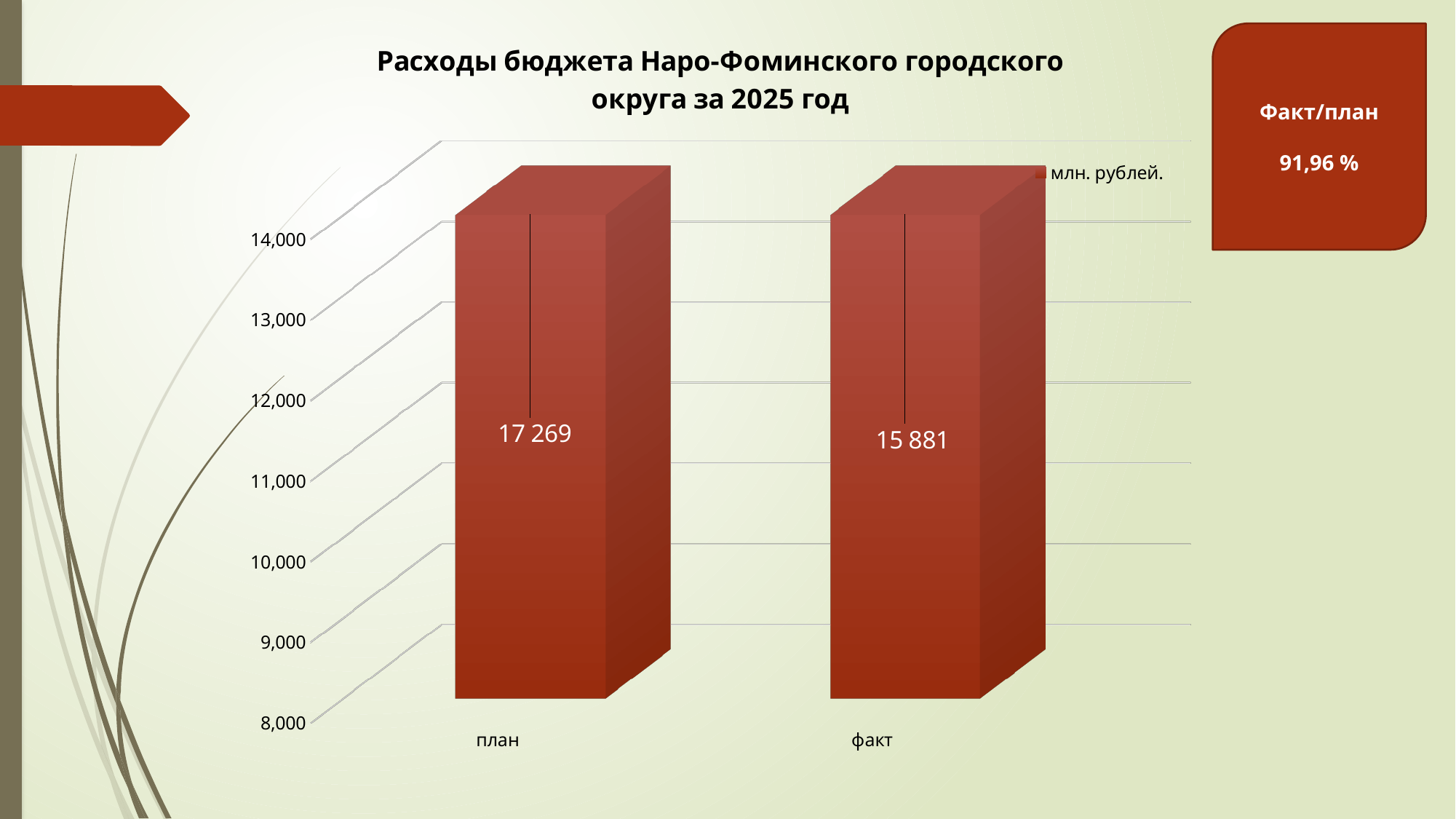
What kind of chart is shown? bar chart How many series does the legend list? 1 What is the difference between the values for план and факт? 1 388 Do the values rise or fall from план to факт? fall What is the value for факт? 15 881 How many categories are shown on the x axis? 2 Which category has the highest value? план What is the title of the chart? Расходы бюджета Наро-Фоминского городского округа за 2025 год Which is larger, the value for план or the value for факт? план Is the value for факт greater or less than 14,000? greater What is the value for план? 17 269 Which category has the lowest value? факт